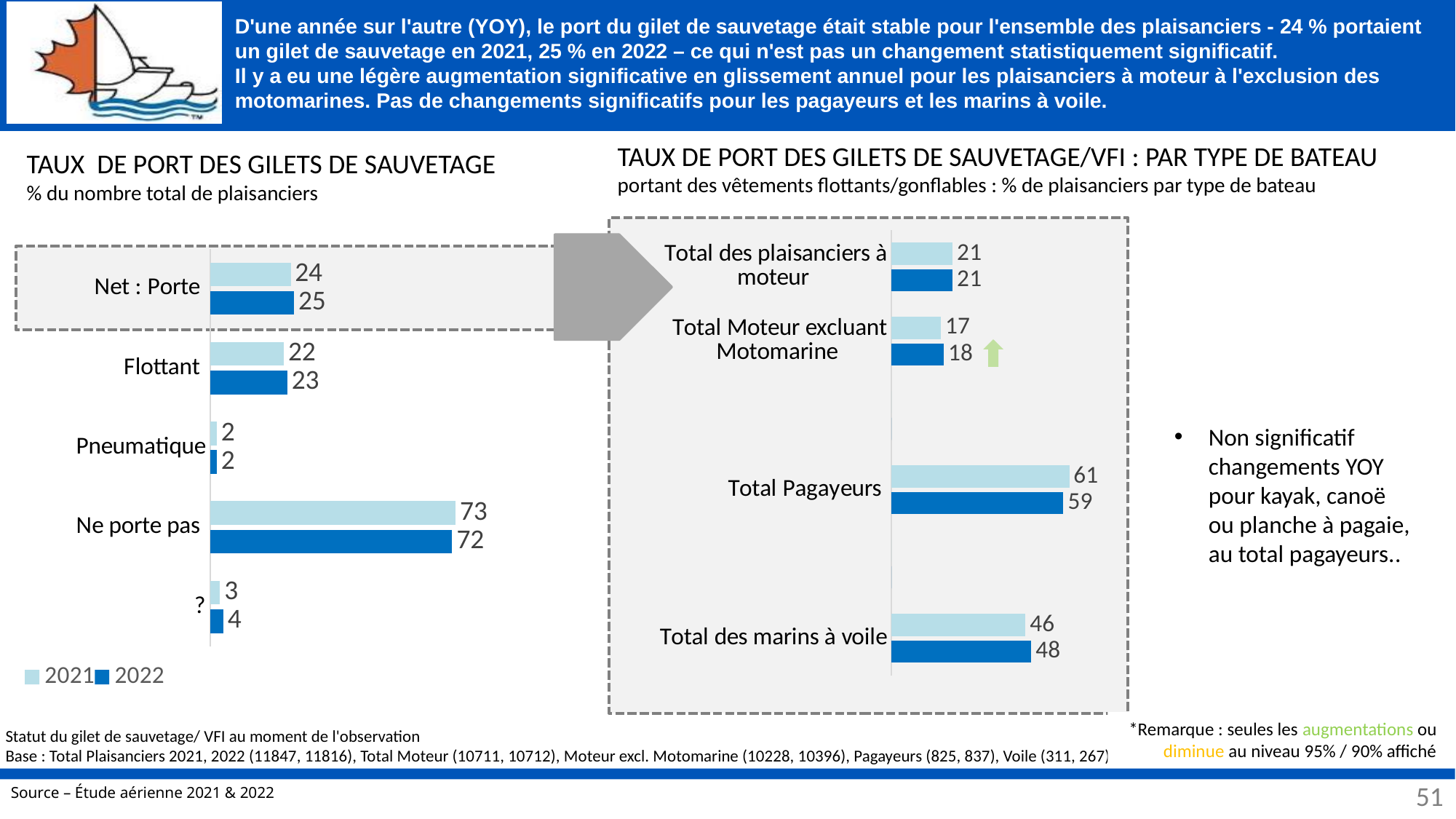
In the left chart 'TAUX DE PORT DES GILETS DE SAUVETAGE', which category has the highest 2021 value? Ne porte pas In the right chart 'TAUX DE PORT DES GILETS DE SAUVETAGE/VFI : PAR TYPE DE BATEAU', what is the 2022 value for 'Total Pagayeurs'? 59 In the left chart 'TAUX DE PORT DES GILETS DE SAUVETAGE', what is the 2021 value for 'Flottant'? 22 In the left chart 'TAUX DE PORT DES GILETS DE SAUVETAGE', how many series does the legend list? 2 In the left chart 'TAUX DE PORT DES GILETS DE SAUVETAGE', which category has the lowest 2022 value? Pneumatique What type of chart is the right chart 'TAUX DE PORT DES GILETS DE SAUVETAGE/VFI : PAR TYPE DE BATEAU'? Bar chart In the left chart 'TAUX DE PORT DES GILETS DE SAUVETAGE', what is the difference between the 2021 and 2022 values for 'Net : Porte'? 1 In the left chart 'TAUX DE PORT DES GILETS DE SAUVETAGE', what is the 2022 value for 'Ne porte pas'? 72 In the left chart 'TAUX DE PORT DES GILETS DE SAUVETAGE', how many categories are shown? 5 In the right chart 'TAUX DE PORT DES GILETS DE SAUVETAGE/VFI : PAR TYPE DE BATEAU', is the 2022 value for 'Total Pagayeurs' larger or smaller than the 2022 value for 'Total des marins à voile'? Larger In the right chart 'TAUX DE PORT DES GILETS DE SAUVETAGE/VFI : PAR TYPE DE BATEAU', what is the 2021 value for 'Total Moteur excluant Motomarine'? 17 In the right chart 'TAUX DE PORT DES GILETS DE SAUVETAGE/VFI : PAR TYPE DE BATEAU', which boat type has the highest 2021 value? Total Pagayeurs